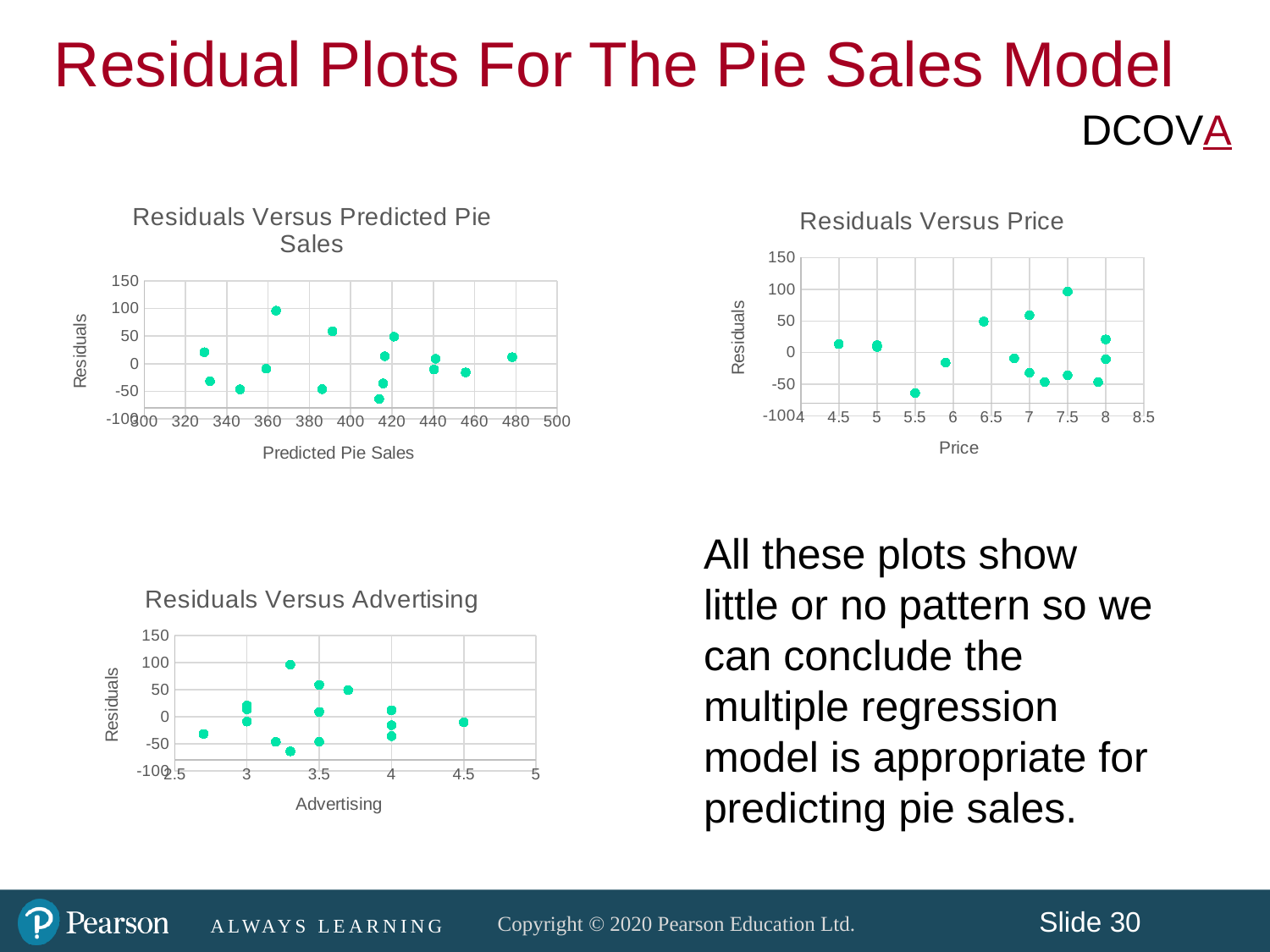
In "Residuals Versus Price", is the highest residual greater or less than 50? greater What kind of chart is "Residuals Versus Advertising"? Scatter plot In "Residuals Versus Predicted Pie Sales", is the lowest residual greater or less than -50? less What is the x-axis title of the chart "Residuals Versus Predicted Pie Sales"? Predicted Pie Sales How many charts are shown on the slide? 3 How many data points are plotted in "Residuals Versus Advertising"? 15 In "Residuals Versus Price", is the residual at a price of 5.5 greater or less than -50? less What kind of chart is "Residuals Versus Price"? Scatter plot What is the y-axis title of the chart "Residuals Versus Advertising"? Residuals How many data points are plotted in "Residuals Versus Predicted Pie Sales"? 15